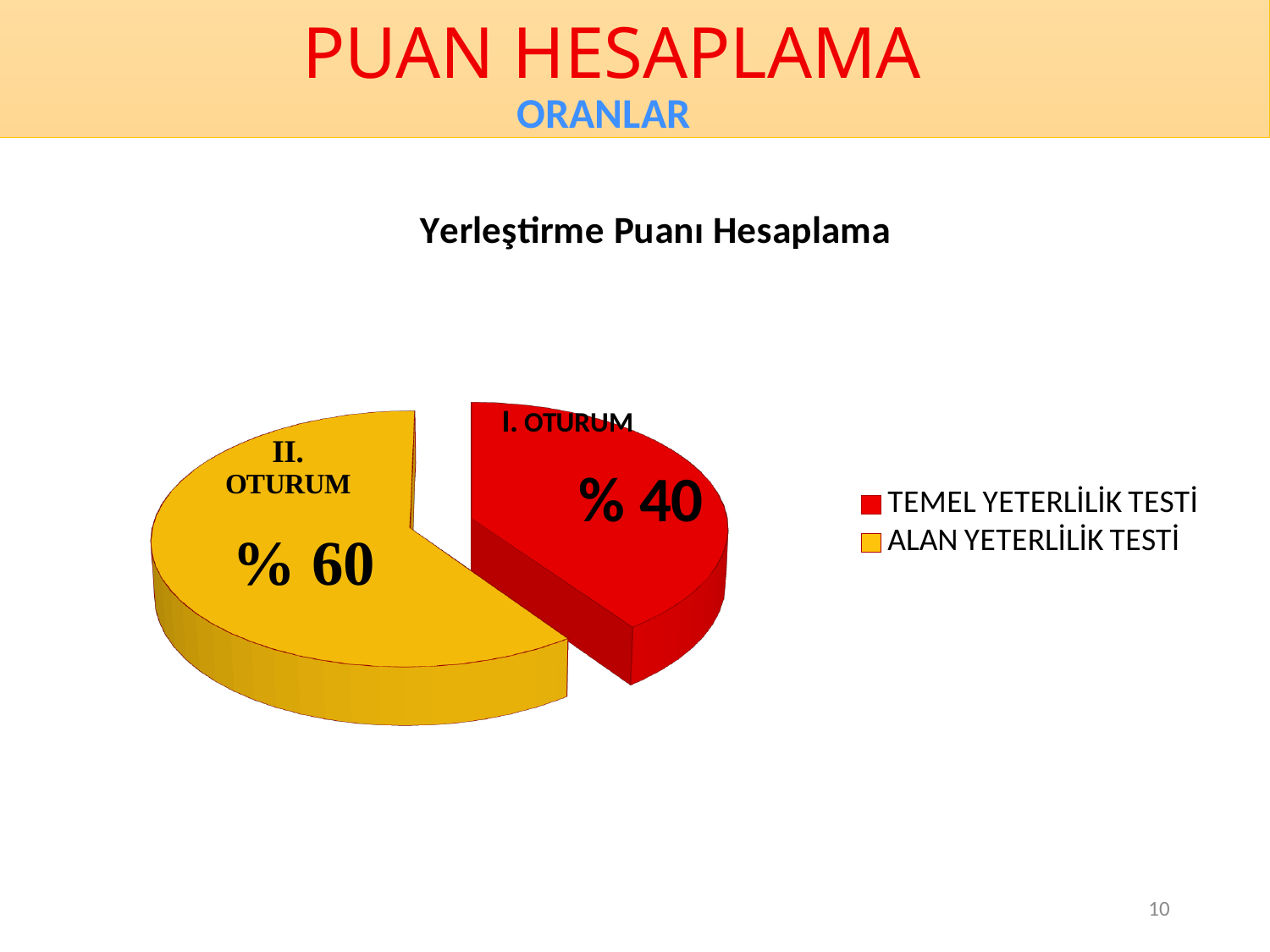
What percentage is shown for the II. OTURUM slice? % 60 How many slices does the pie chart have? 2 Which slice is the largest? II. OTURUM How many entries does the legend list? 2 Which slice is the smallest? I. OTURUM What is the chart's title? Yerleştirme Puanı Hesaplama Which legend entry is shown in red? TEMEL YETERLİLİK TESTİ What is the difference between the II. OTURUM and I. OTURUM percentages? 20 What kind of chart is shown on the slide? pie chart Which is larger, the I. OTURUM slice or the II. OTURUM slice? II. OTURUM What percentage is shown for the I. OTURUM slice? % 40 What share of the pie does the I. OTURUM slice represent? % 40